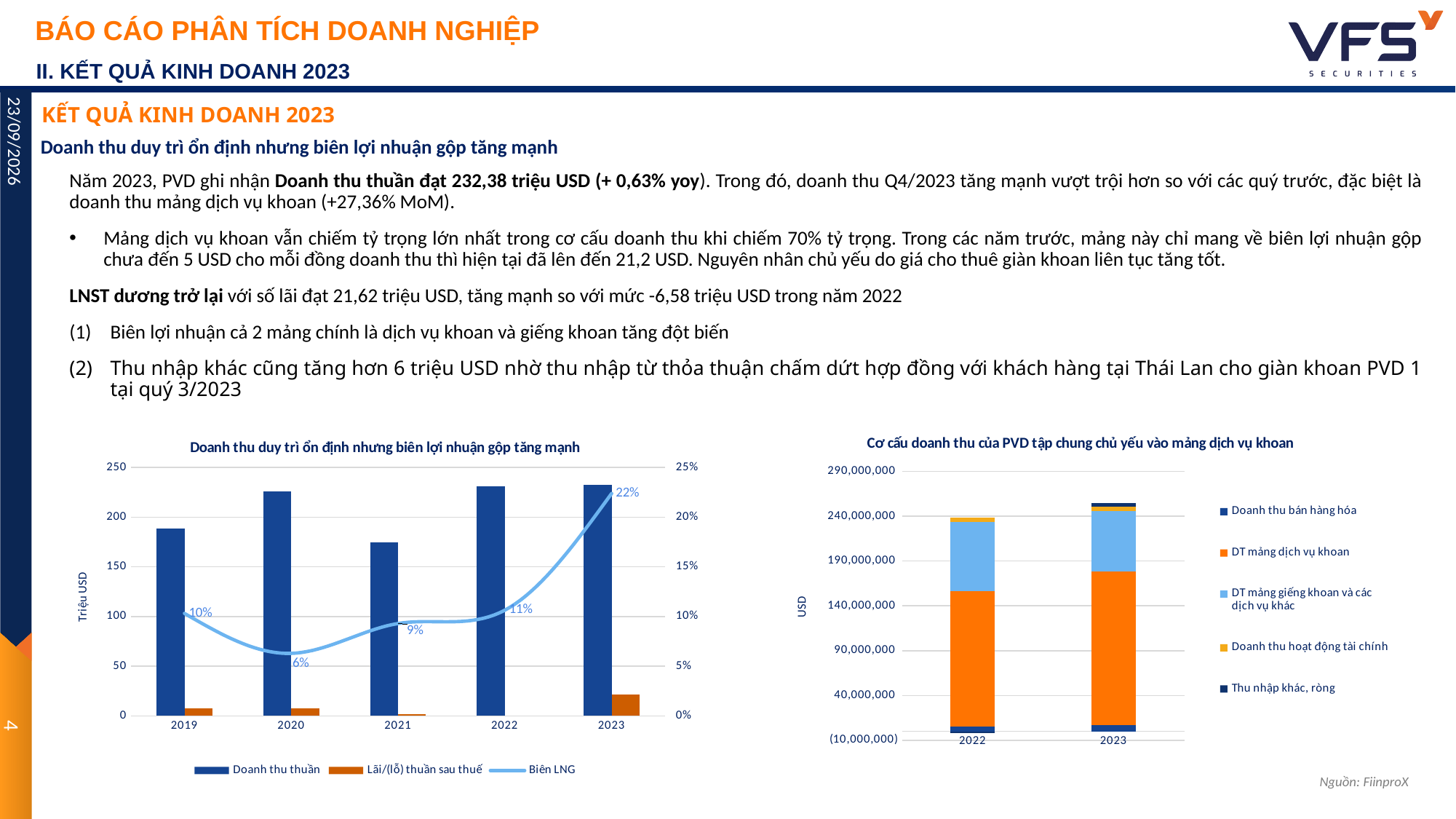
In the left chart, how many series does the legend list? 3 In the left chart, which year has the larger Doanh thu thuần bar, 2020 or 2021? 2020 In the right chart 'Cơ cấu doanh thu của PVD tập chung chủ yếu vào mảng dịch vụ khoan', how many series does the legend list? 5 In the left chart, what is the difference between the Biên LNG for 2023 and for 2022? 11% In the left chart 'Doanh thu duy trì ổn định nhưng biên lợi nhuận gộp tăng mạnh', what is the Biên LNG value for 2023? 22% In the left chart, what is the Biên LNG value for 2020? 6% In the left chart, does the Biên LNG line rise or fall from 2020 to 2023? rise In the left chart, which year has the lowest Biên LNG? 2020 In the left chart, how many years are shown on the x axis? 5 In the left chart, is the Doanh thu thuần value for 2019 greater or less than 150? greater In the right chart, which series takes up the largest portion of the 2023 stacked bar? DT mảng dịch vụ khoan In the left chart, which year has the highest Biên LNG? 2023